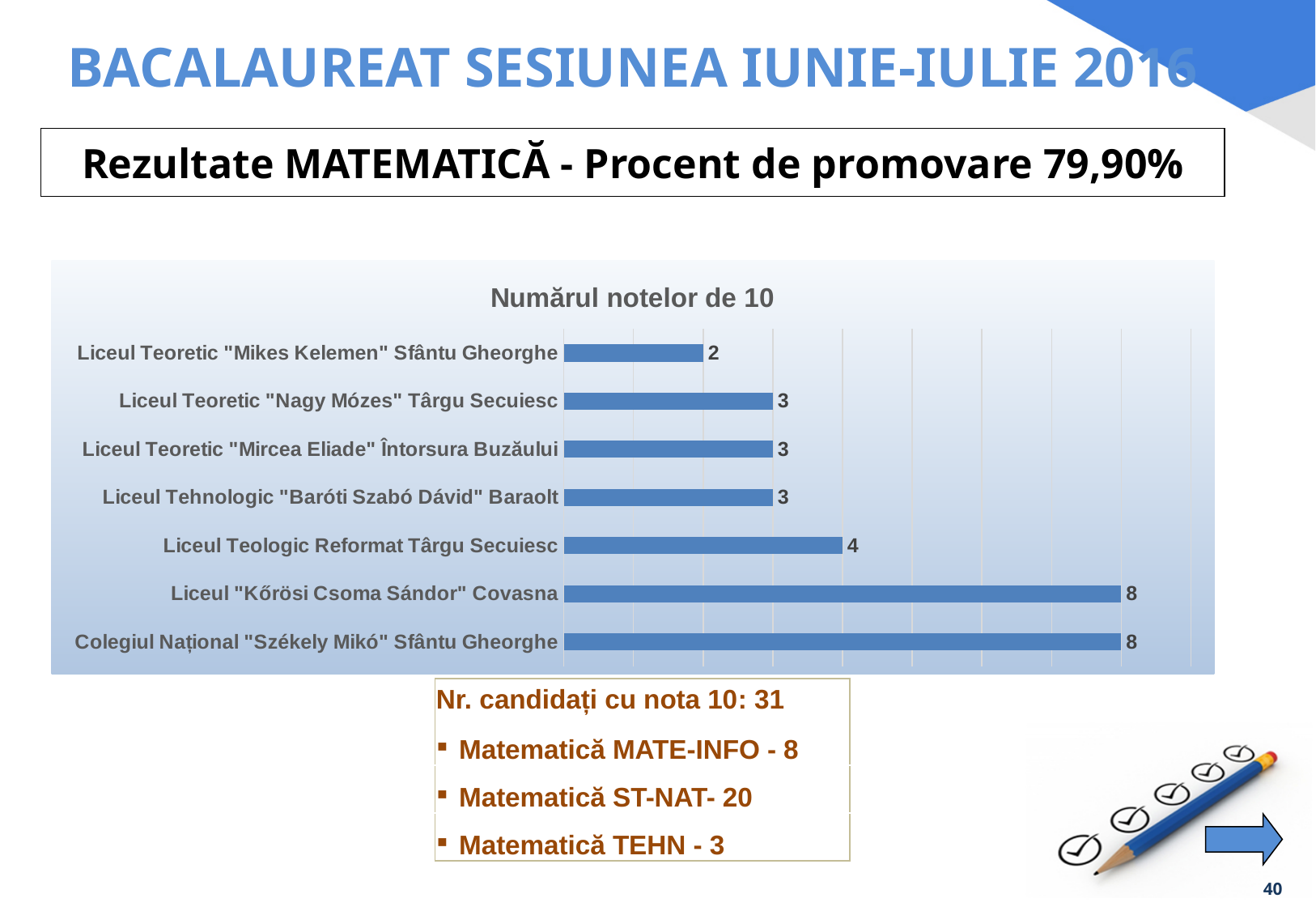
How many schools (categories) are shown in the chart? 7 What is the value for Colegiul Național "Székely Mikó" Sfântu Gheorghe? 8 What is the value for Liceul Tehnologic "Baróti Szabó Dávid" Baraolt? 3 What is the difference between the value for Colegiul Național "Székely Mikó" Sfântu Gheorghe and the value for Liceul Teoretic "Mircea Eliade" Întorsura Buzăului? 5 What is the difference between the value for Liceul "Kőrösi Csoma Sándor" Covasna and the value for Liceul Teologic Reformat Târgu Secuiesc? 4 What is the title of the chart? Numărul notelor de 10 What is the value for Liceul Teologic Reformat Târgu Secuiesc? 4 What is the value for Liceul Teoretic "Mikes Kelemen" Sfântu Gheorghe? 2 What is the highest value shown in the chart? 8 What kind of chart is shown on the slide? bar chart Which school has the lowest number of grades of 10? Liceul Teoretic "Mikes Kelemen" Sfântu Gheorghe Which is larger: the value for Liceul Teoretic "Nagy Mózes" Târgu Secuiesc or the value for Liceul Teoretic "Mikes Kelemen" Sfântu Gheorghe? Liceul Teoretic "Nagy Mózes" Târgu Secuiesc